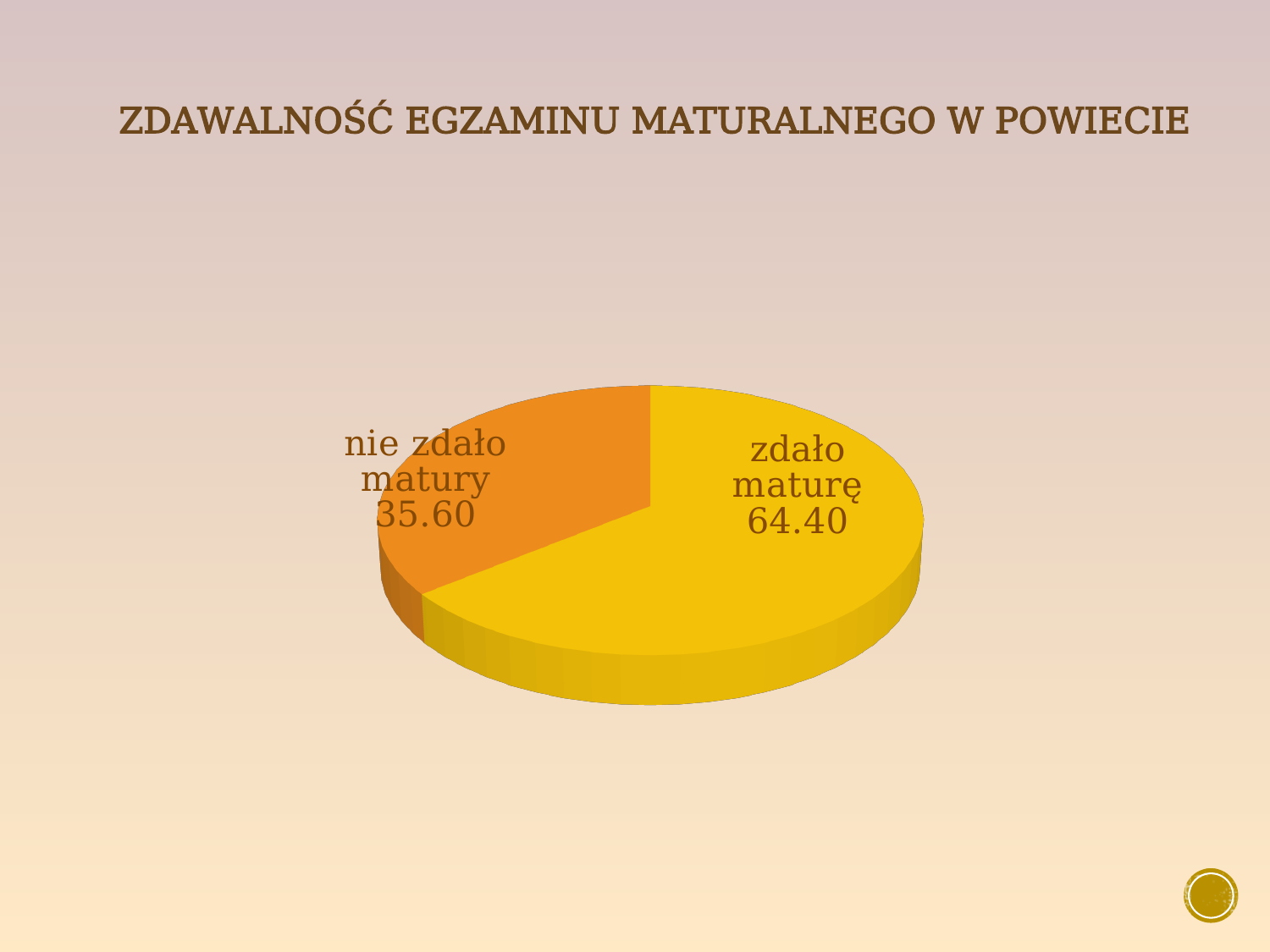
What colour is the "nie zdało matury" slice? orange What is the value for "zdało maturę"? 64.40 What kind of chart is shown on the slide? pie chart Which slice is the largest? zdało maturę Which is larger: "zdało maturę" or "nie zdało matury"? zdało maturę Which slice is the smallest? nie zdało matury How many slices does the pie chart have? 2 What is the difference between the values for "zdało maturę" and "nie zdało matury"? 28.80 What is the total of the two slice values? 100.00 What is the title of the slide? ZDAWALNOŚĆ EGZAMINU MATURALNEGO W POWIECIE What is the value for "nie zdało matury"? 35.60